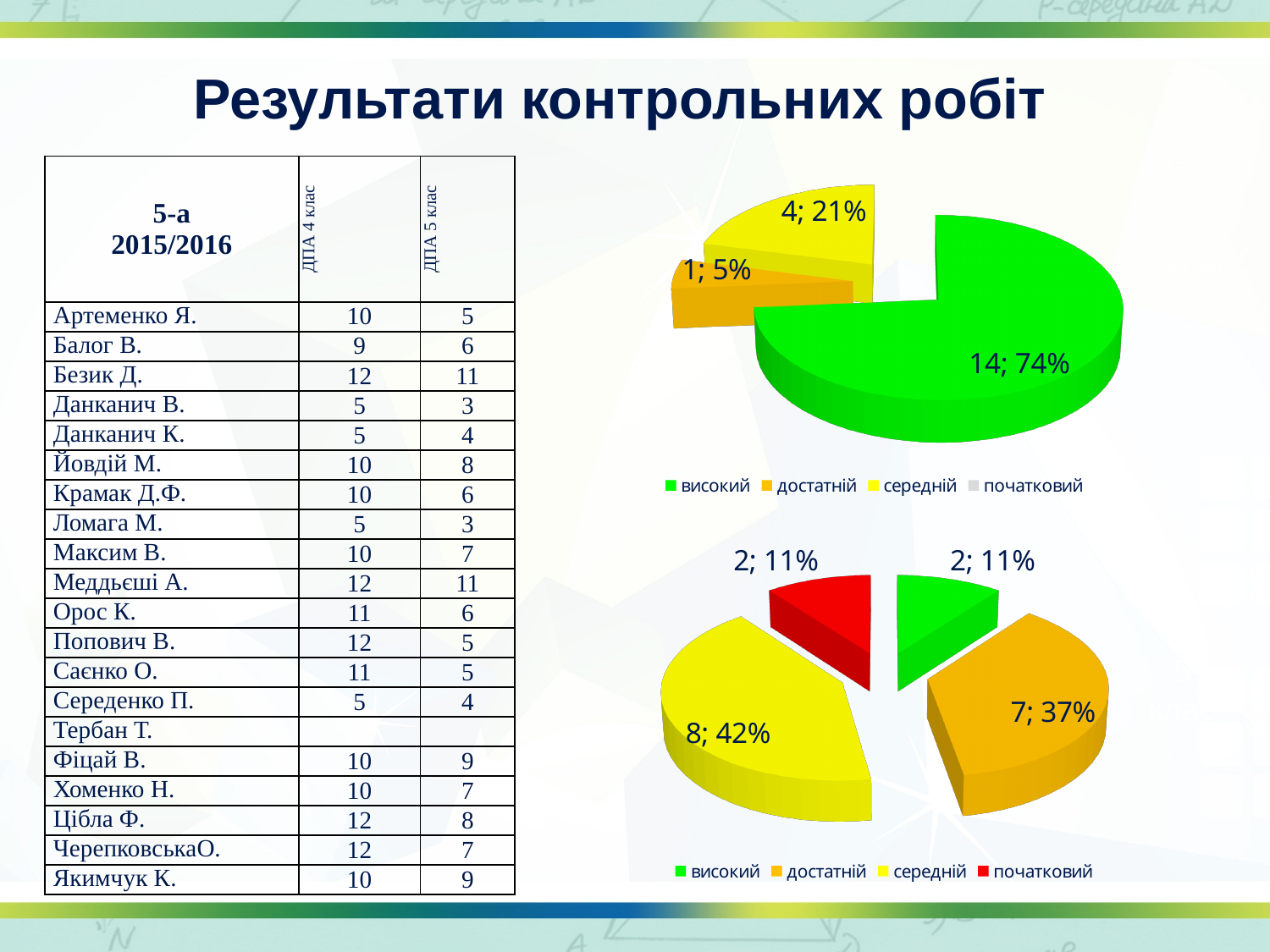
In the bottom pie chart, what is the difference between the values of the 'середній' and 'достатній' slices? 1 In the bottom pie chart, which category has the largest slice? середній In the top pie chart, which category has the largest slice? високий How many entries does the legend of the top pie chart list? 4 In the bottom pie chart, what share does the 'достатній' slice have? 37% In the bottom pie chart, what value and share are shown for the 'середній' slice? 8; 42% What kind of chart is the top chart on the right of the slide? pie chart In the top pie chart, what share does the 'середній' slice have? 21% In the bottom pie chart, which is larger: the 'достатній' slice or the 'початковий' slice? достатній In the top pie chart, what value and share are shown for the green 'високий' slice? 14; 74% In the bottom pie chart, what colour is the 'початковий' slice? red In the top pie chart, what value is shown for the 'достатній' slice? 1